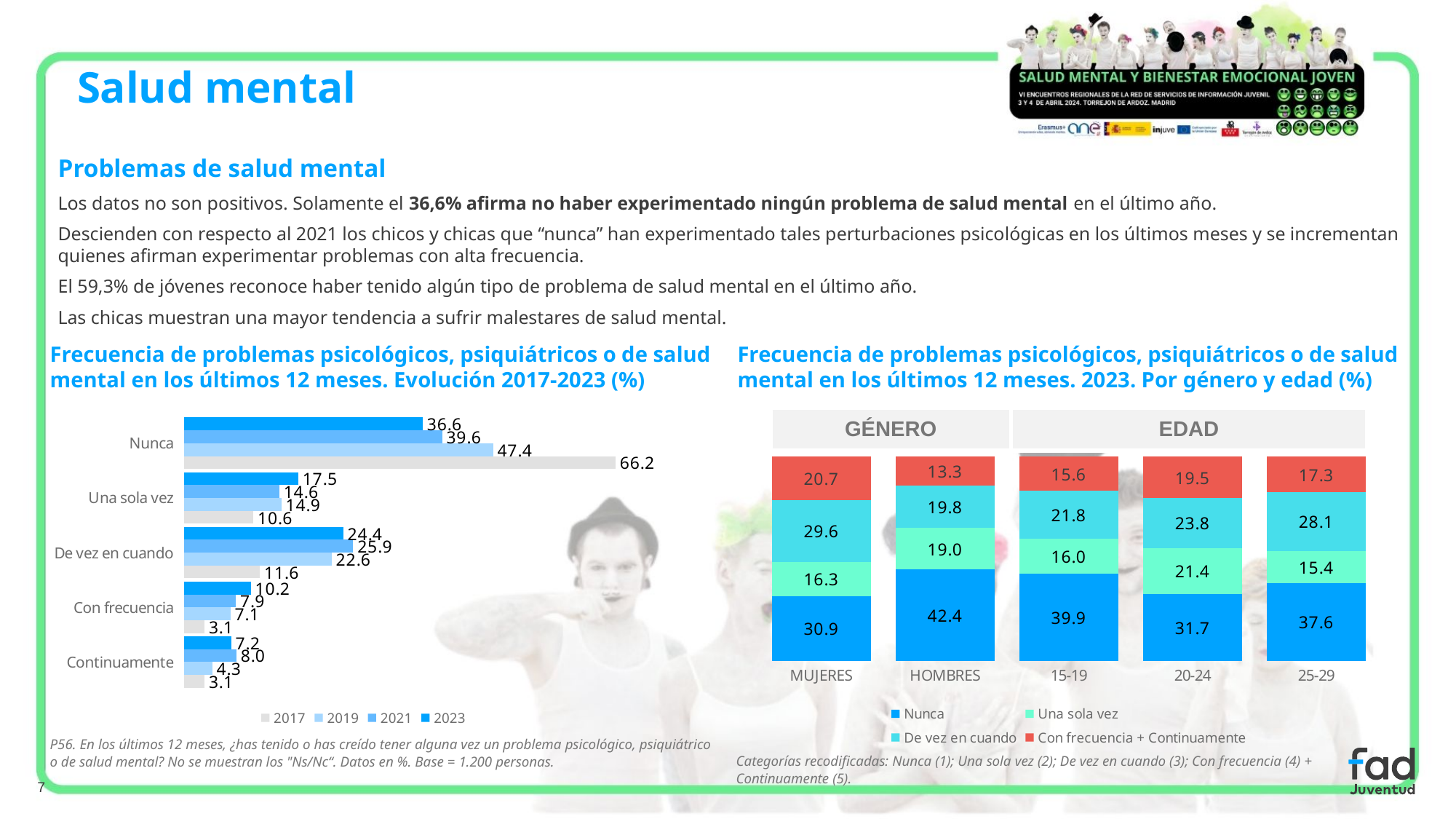
In the left chart (Evolución 2017-2023), what is the 2017 value for "Nunca"? 66.2 In the left chart (Evolución 2017-2023), what is the 2023 value for "Nunca"? 36.6 In the right chart (Por género y edad), which age group has the highest "Nunca" value? 15-19 In the left chart (Evolución 2017-2023), what kind of chart is it? Bar chart In the left chart (Evolución 2017-2023), how many series does the legend list? 4 In the right chart (Por género y edad), what is the "Nunca" value for HOMBRES? 42.4 In the right chart (Por género y edad), what is the difference between the "Nunca" values for HOMBRES and MUJERES? 11.5 In the right chart (Por género y edad), what is the "Con frecuencia + Continuamente" value for MUJERES? 20.7 In the right chart (Por género y edad), how many bars (categories) are shown? 5 In the left chart (Evolución 2017-2023), which is larger for "Con frecuencia": the 2023 value or the 2017 value? 2023 In the left chart (Evolución 2017-2023), by how much did the "Nunca" value fall from 2017 to 2023? 29.6 In the left chart (Evolución 2017-2023), what is the 2021 value for "De vez en cuando"? 25.9